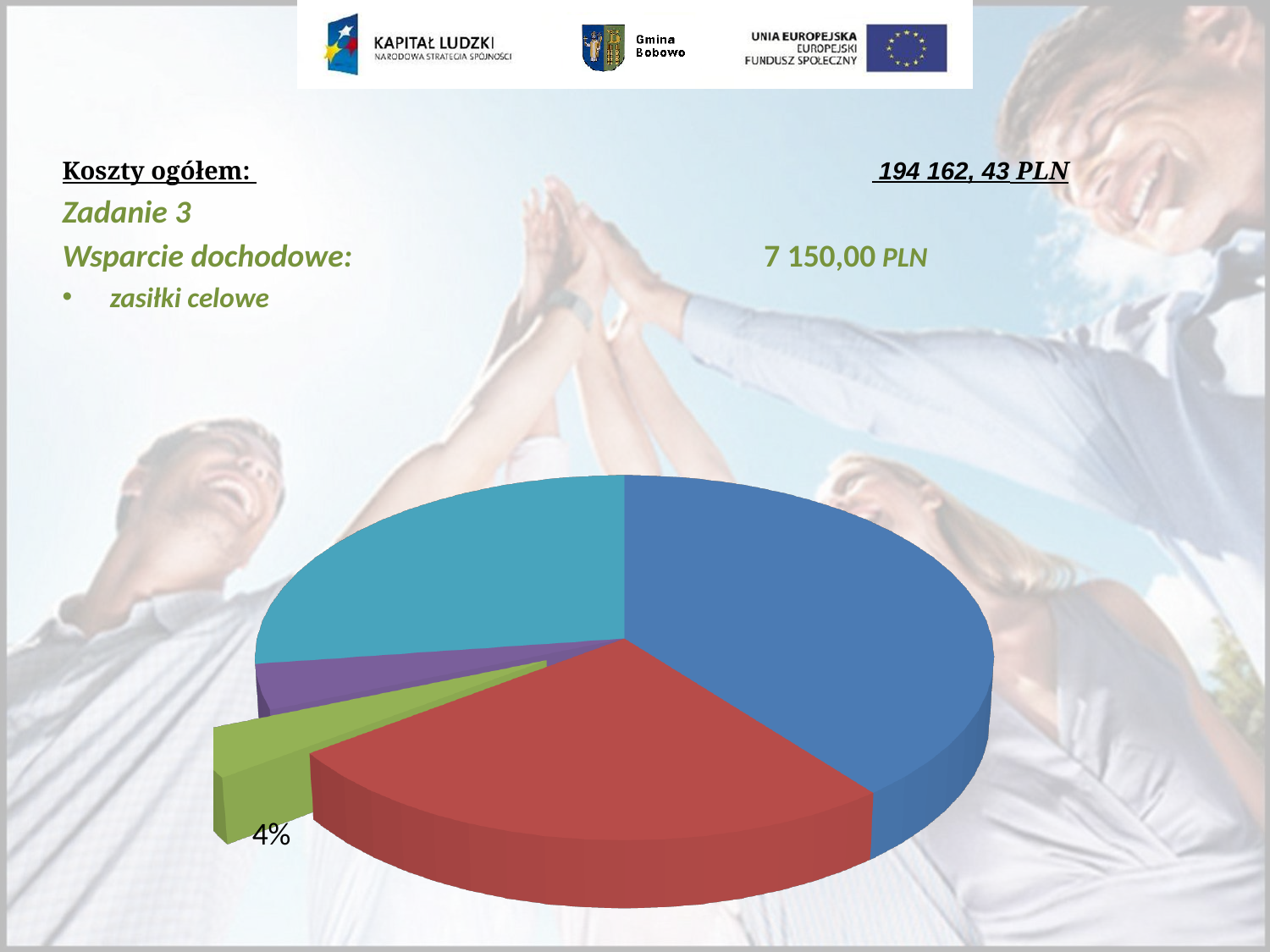
How many slices does the pie chart have? 5 What kind of chart is shown on the slide? pie chart What percentage is shown on the green slice that is pulled out from the pie? 4% Which is larger, the blue slice or the red slice? the blue slice Which slice of the pie chart is the largest? the blue slice Which is larger, the blue slice or the teal slice? the blue slice Which is larger, the red slice or the green slice? the red slice Which slice is pulled out (exploded) from the rest of the pie? the green slice How many slices of the pie chart have a data label printed on them? 1